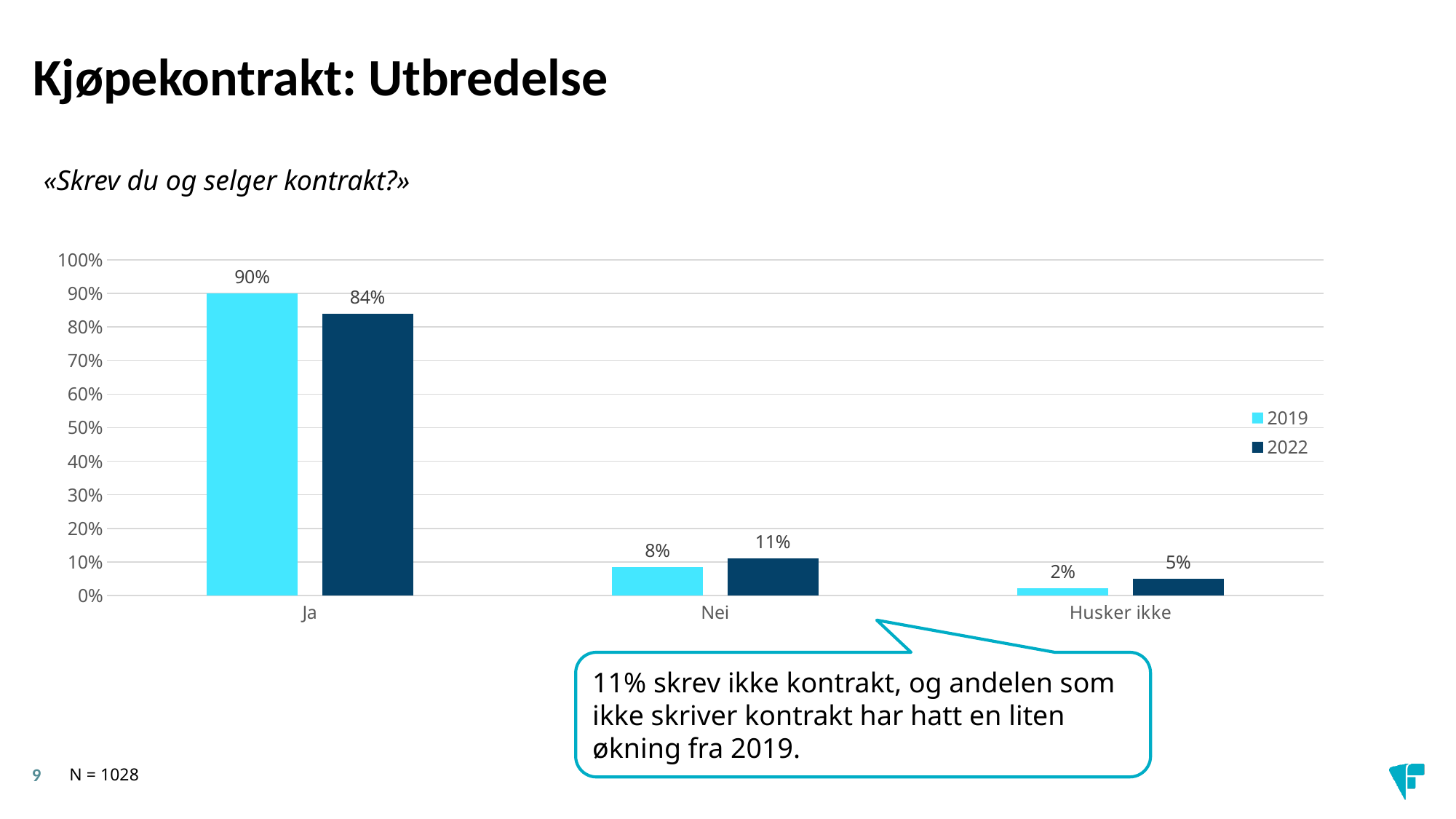
What kind of chart is shown on the slide? Bar chart How many series does the legend list? 2 What is the value for "Husker ikke" in the 2019 series? 2% What is the difference between the 2022 and 2019 values for "Nei"? 3% Which is larger for "Husker ikke": the 2019 value or the 2022 value? 2022 What is the value for "Ja" in the 2019 series? 90% What is the value for "Nei" in the 2022 series? 11% Which category has the lowest value in the 2019 series? Husker ikke Is the 2022 value for "Ja" greater or less than 80%? greater What is the difference between the 2019 and 2022 values for "Ja"? 6% Which category has the highest value in the 2022 series? Ja How many categories are shown on the x axis? 3